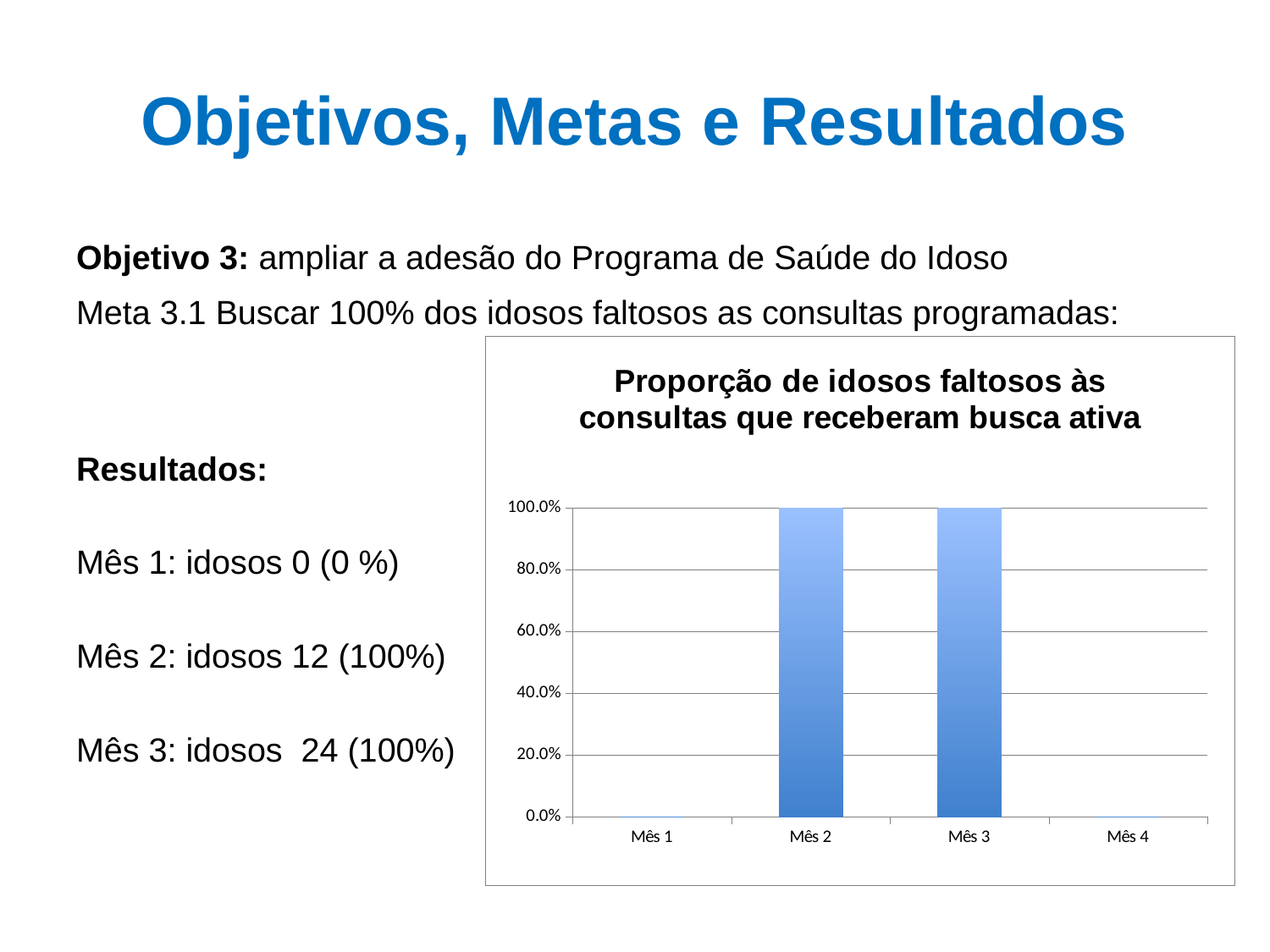
What type of chart is shown on the slide? bar chart Is the value for Mês 1 greater or less than 20.0%? less How many visible bars does the chart have? 2 Which is larger, the value for Mês 3 or the value for Mês 4? Mês 3 How many categories are shown on the x axis of the chart? 4 What is the value for Mês 2 in the chart? 100.0% What is the difference between the values for Mês 2 and Mês 3? 0.0% Does the value rise or fall from Mês 1 to Mês 2? rise Which is larger, the value for Mês 1 or the value for Mês 2? Mês 2 What is the value for Mês 3 in the chart? 100.0% Is the value for Mês 2 greater or less than 80.0%? greater What is the title of the chart? Proporção de idosos faltosos às consultas que receberam busca ativa